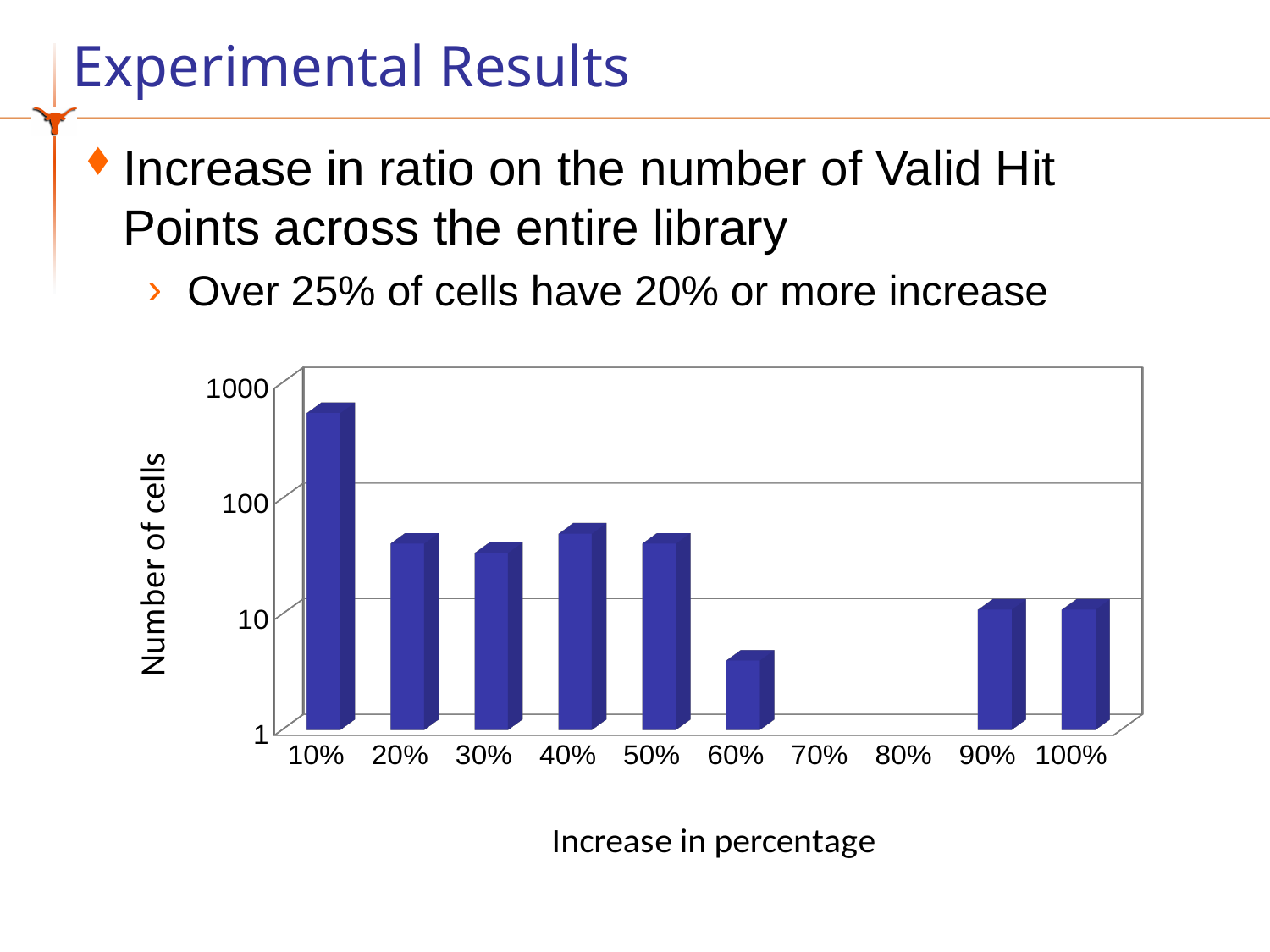
Is the number of cells for 20% greater or less than 100? less Is the number of cells for 10% greater or less than 100? greater How many categories are shown on the x axis? 10 Which has more cells, 10% or 20%? 10% Which has more cells, 40% or 60%? 40% What kind of chart is shown on the slide? bar chart Is the number of cells for 60% greater or less than 10? less What is the label of the y axis? Number of cells Among the categories with a visible bar, which has the lowest number of cells? 60% What is the label of the x axis? Increase in percentage Which category has the highest number of cells? 10%